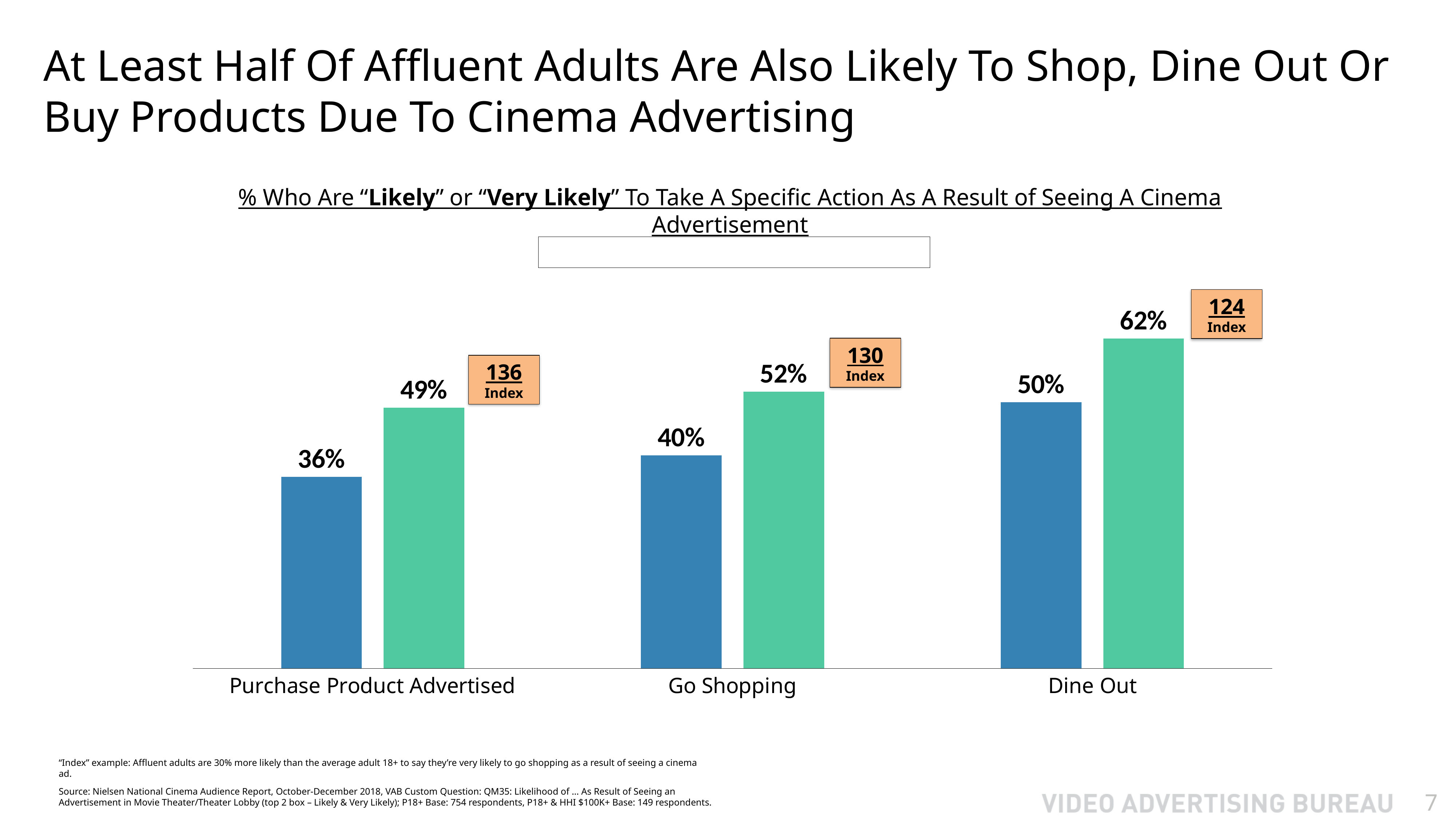
What index value is shown for Purchase Product Advertised? 136 Which category has the highest green bar? Dine Out What is the difference between the green bar and the blue bar for Dine Out? 12 percentage points What is the value of the green bar for Go Shopping? 52% Which is larger: the blue bar for Dine Out or the green bar for Purchase Product Advertised? The blue bar for Dine Out (50%) What is the value of the green bar for Dine Out? 62% What kind of chart is shown on the slide? Bar chart Which category has the lowest blue bar? Purchase Product Advertised Which category has the lowest index value? Dine Out How many categories are shown on the x axis? 3 What is the value of the blue bar for Purchase Product Advertised? 36% What index value is shown for Go Shopping? 130